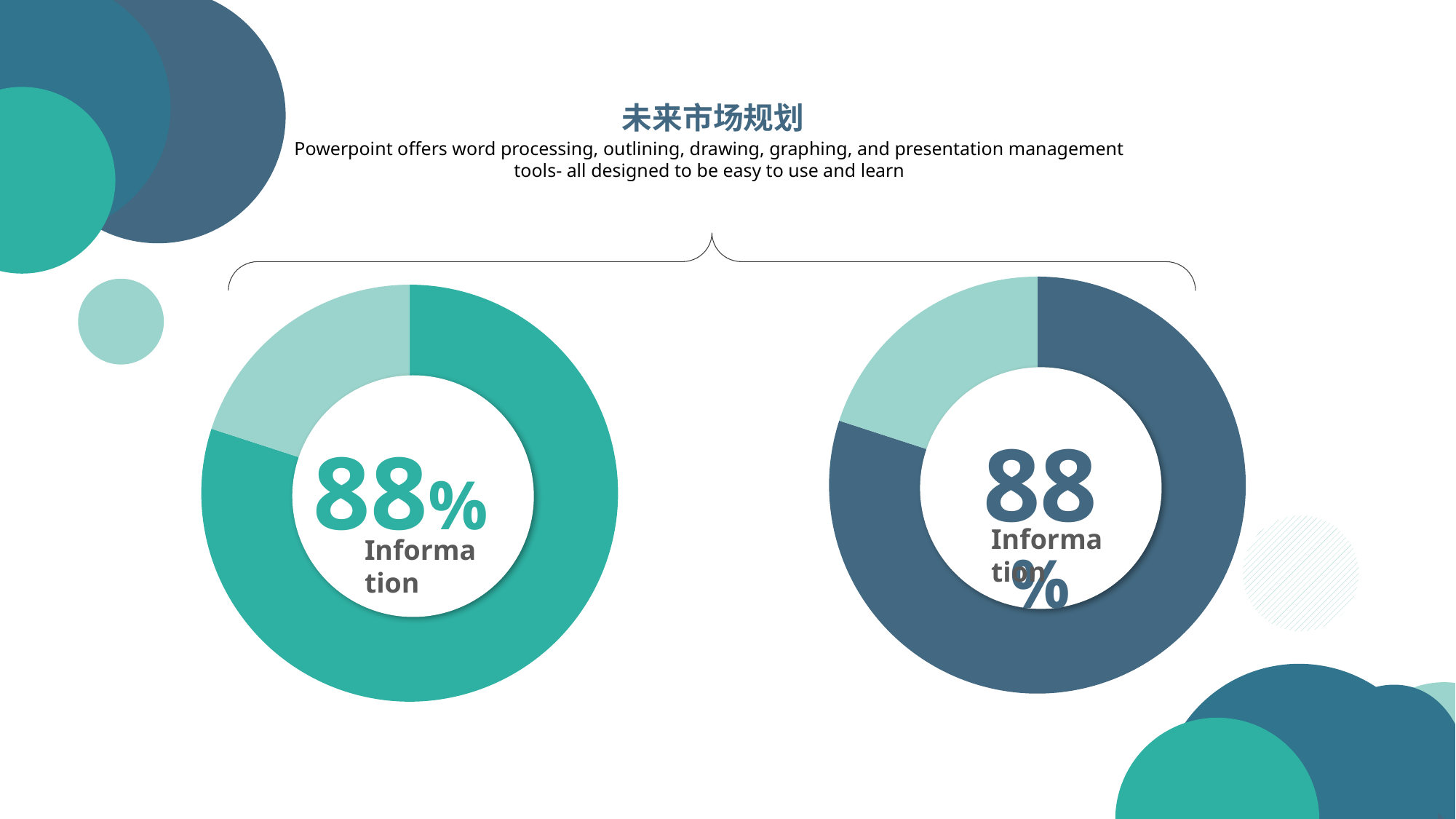
How many slices does the right donut chart have? 2 Is the percentage printed in the left donut chart larger, smaller, or the same as the one printed in the right donut chart? The same How many slices does the left donut chart have? 2 What text label appears below the percentage in the centre of the left donut chart? Information What kind of chart is shown on the right side of the slide? Donut chart What kind of chart is shown on the left side of the slide? Donut chart What percentage is printed in the centre of the left donut chart? 88% How many charts are on the slide? 2 In the left donut chart, which slice is larger, the dark teal one or the light teal one? The dark teal one What is the title of the slide above the two donut charts? 未来市场规划 What percentage is printed in the centre of the right donut chart? 88% In the right donut chart, which slice is larger, the dark blue one or the light teal one? The dark blue one